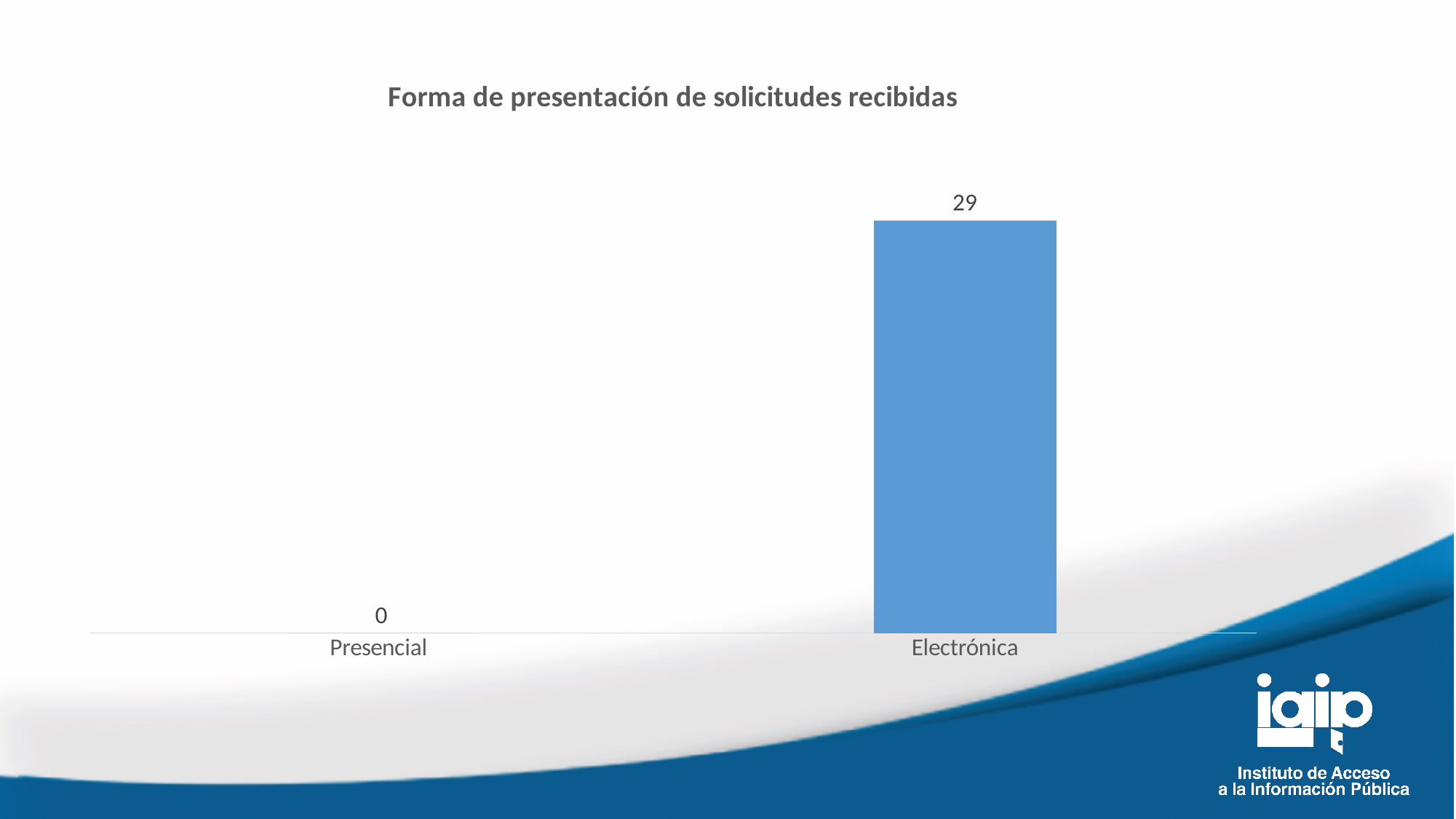
What kind of chart is shown on the slide? Bar chart How many categories are shown on the x axis? 2 What is the value for Electrónica? 29 What is the difference between the values for Electrónica and Presencial? 29 What is the value for Presencial? 0 Do the values rise or fall from Presencial to Electrónica? Rise Which is larger, the value for Presencial or the value for Electrónica? Electrónica What is the title of the chart? Forma de presentación de solicitudes recibidas What is the total of the values for Presencial and Electrónica? 29 What colour is the bar for Electrónica? Blue Which category has the highest value? Electrónica Which category has the lowest value? Presencial